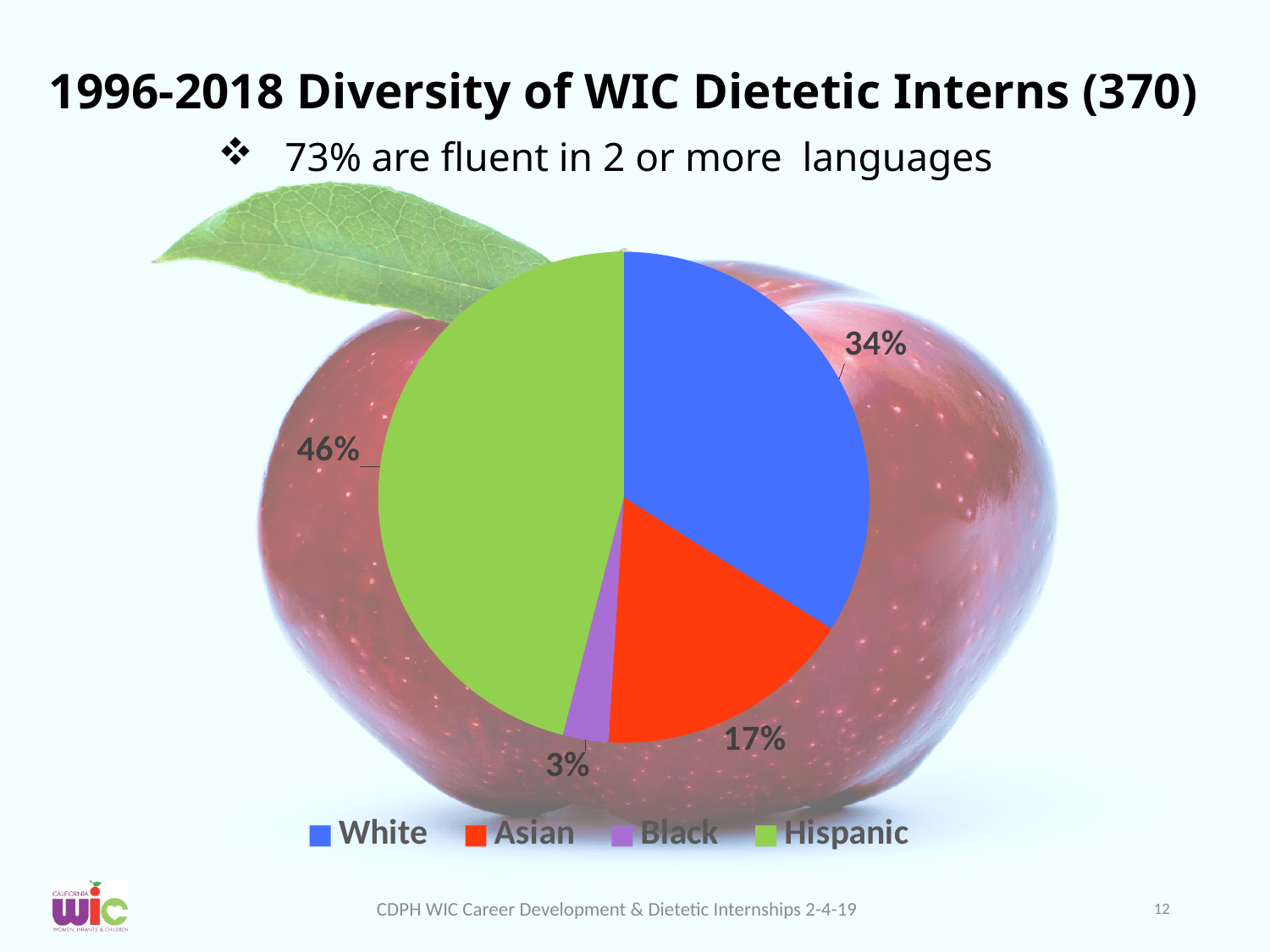
What kind of chart is shown on the slide? pie chart What percentage of WIC dietetic interns are Hispanic? 46% What percentage of WIC dietetic interns are Asian? 17% What percentage of WIC dietetic interns are White? 34% How many groups are shown in the pie chart? 4 Which group has the largest share of the pie? Hispanic Which group has the smallest share of the pie? Black What is the difference in percentage points between the Hispanic and White shares? 12 Which share is larger, Asian or White? White What is the combined share of the Asian and Black slices? 20% Which colour represents Hispanic in the legend? green What percentage of WIC dietetic interns are Black? 3%